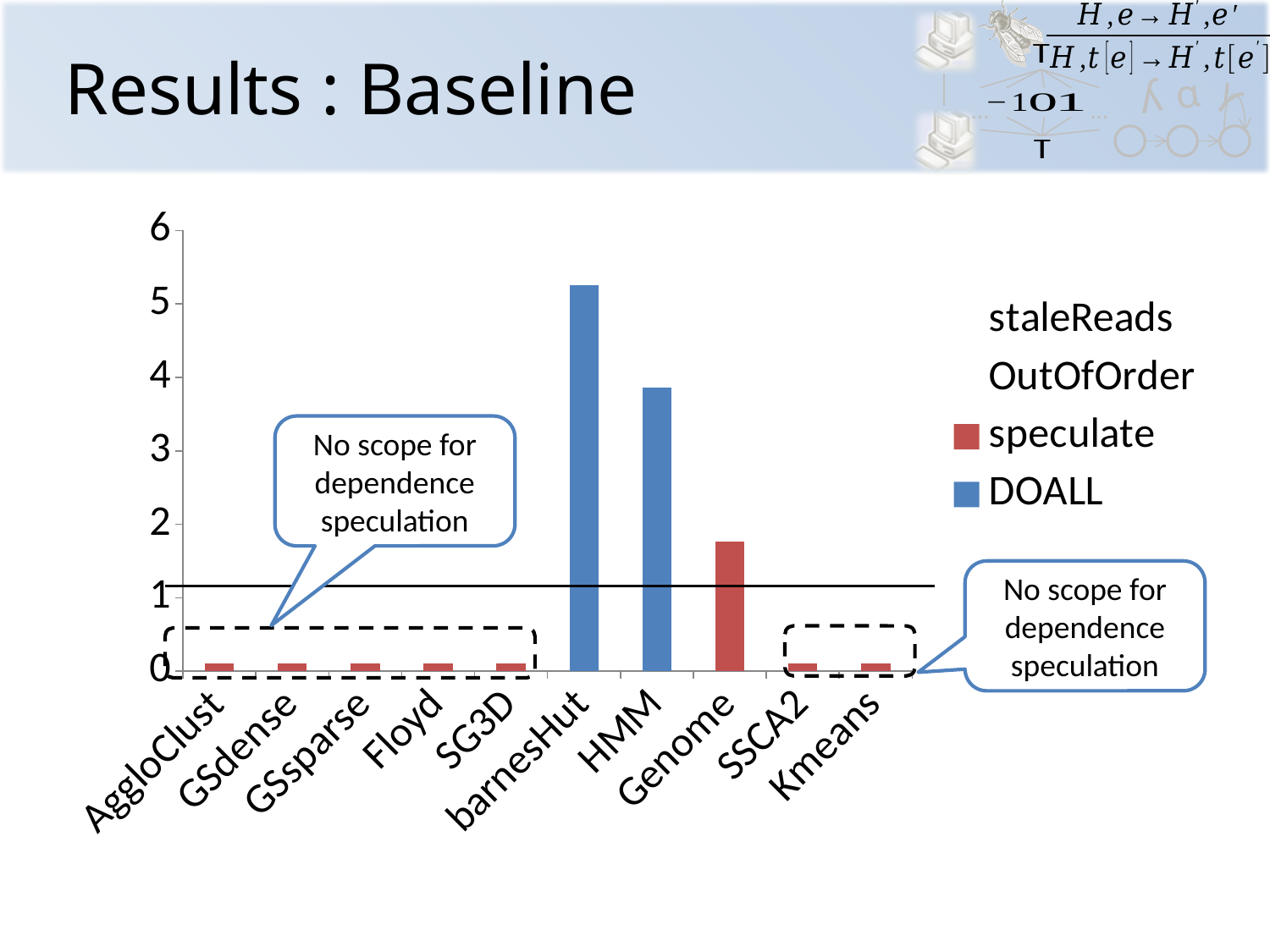
Which colour represents the DOALL series in the legend? blue Is the value for Genome greater or less than 2? less What kind of chart is shown on the slide? bar chart Is the value for HMM greater or less than 4? less Which is larger, the value for Genome or the value for HMM? HMM Is the value for AggloClust greater or less than 1? less Which is larger, the value for barnesHut or the value for HMM? barnesHut Which category has the highest bar in the chart? barnesHut How many categories are shown along the x axis of the chart? 10 How many series does the chart's legend list? 4